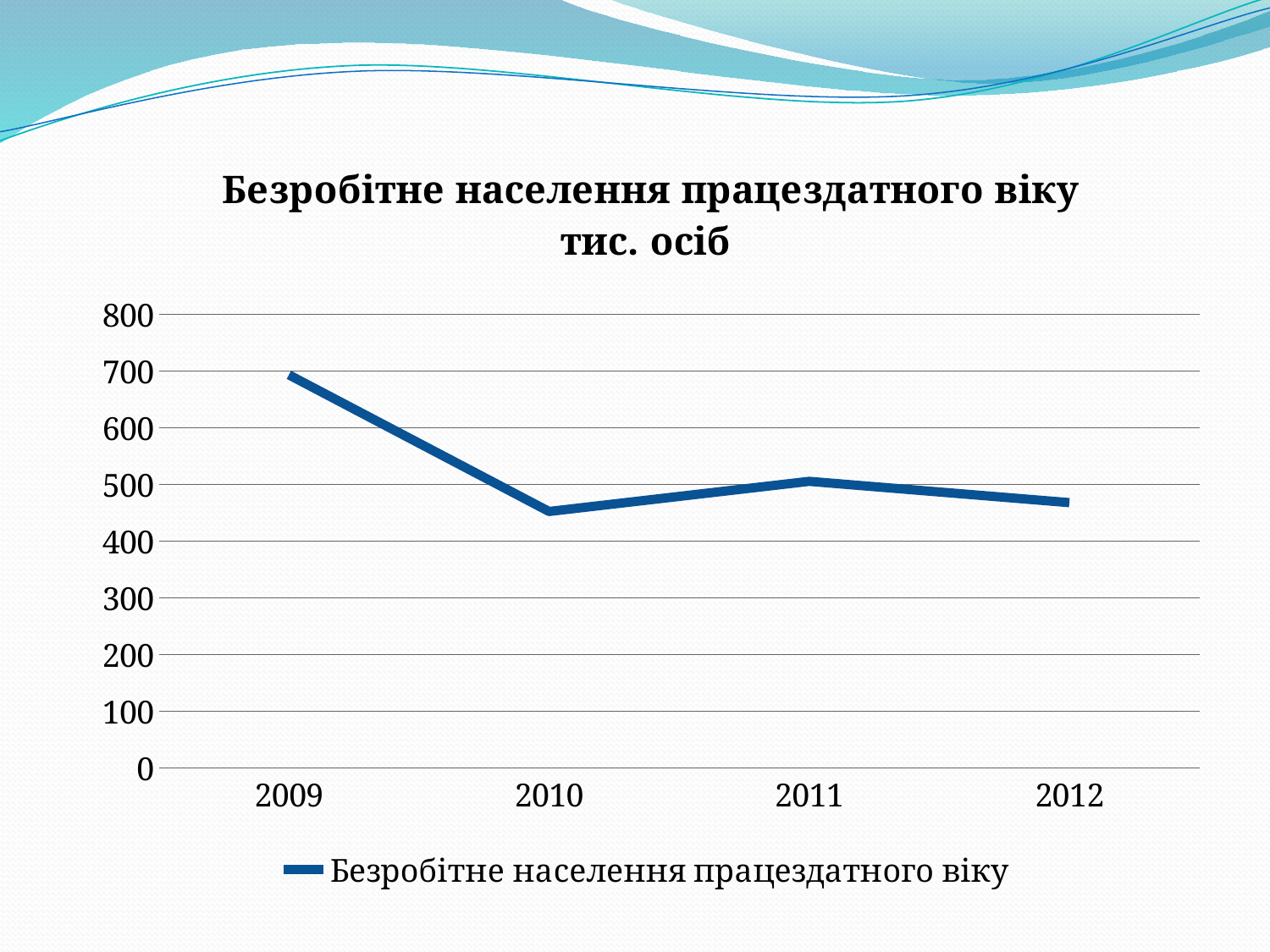
How many years are plotted on the x axis of the chart? 4 How many series does the chart's legend list? 1 Does the value overall rise or fall from 2009 to 2012? fall Is the value for 2012 greater or less than 600? less Is the value for 2010 greater or less than 500? less Which year has the larger value, 2009 or 2010? 2009 Is the value for 2009 greater or less than 600? greater Which year has the larger value, 2010 or 2011? 2011 What unit is given in the chart title? тис. осіб Which year has the highest value for unemployed working-age population? 2009 What kind of chart is shown on the slide? line chart